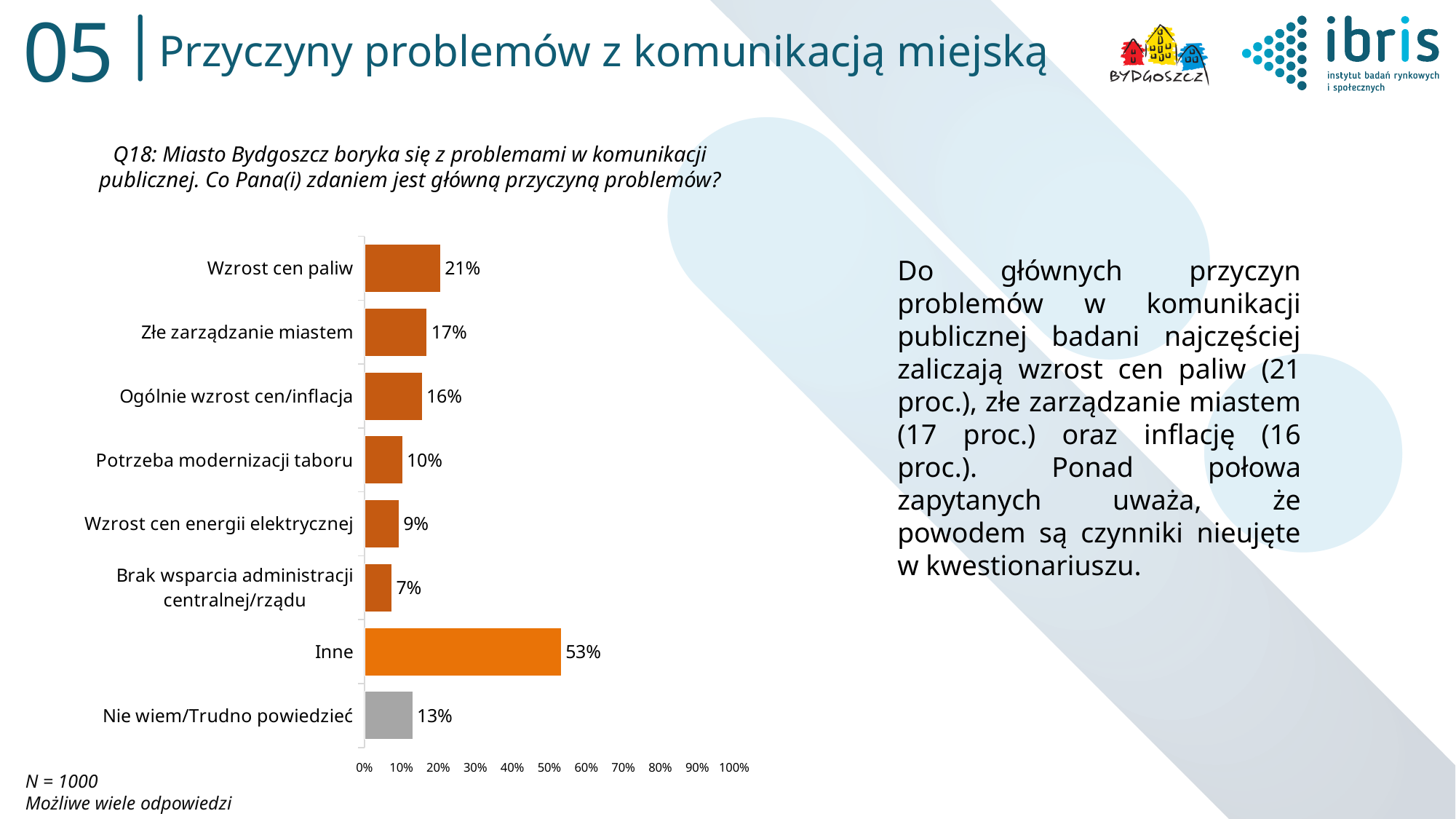
Which category has the lowest value? Brak wsparcia administracji centralnej/rządu What is the sample size (N) stated below the chart? N = 1000 What is the value for Potrzeba modernizacji taboru? 10% Which category has the highest value? Inne What is the difference between the values for Złe zarządzanie miastem and Wzrost cen energii elektrycznej? 8% What is the value for Wzrost cen paliw? 21% Which is larger, the value for Ogólnie wzrost cen/inflacja or the value for Nie wiem/Trudno powiedzieć? Ogólnie wzrost cen/inflacja How many categories are shown in the chart? 8 What is the value for Nie wiem/Trudno powiedzieć? 13% What is the difference between the values for Inne and Wzrost cen paliw? 32% What kind of chart is shown on the slide? bar chart Is the value for Inne greater or less than 50%? greater